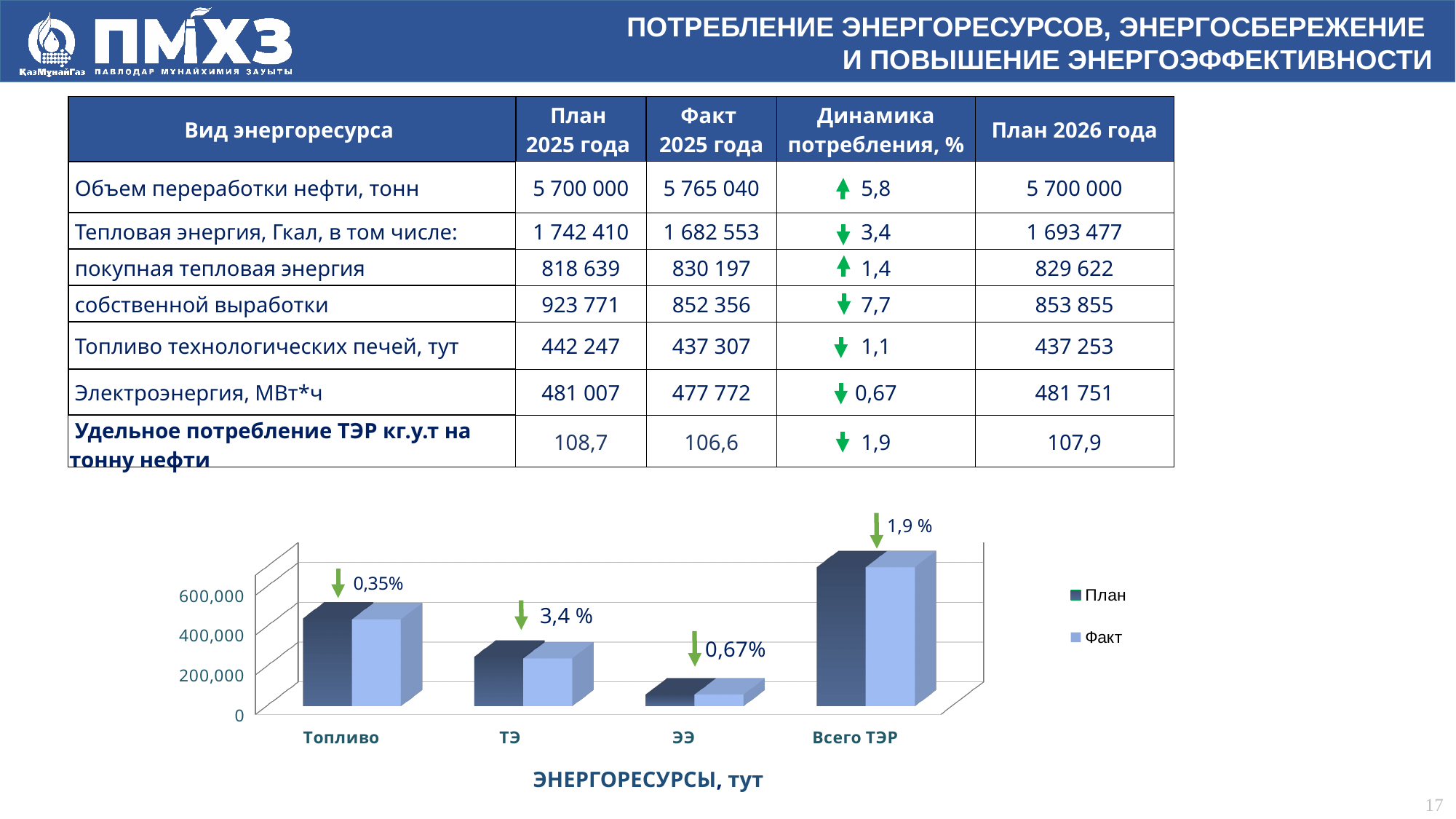
Which category has the highest bars in the chart? Всего ТЭР Is the План value for ТЭ greater or less than 400,000? less How many categories are shown on the x axis of the chart? 4 Is the Факт value for ЭЭ greater or less than 200,000? less Which category has the lowest bars in the chart? ЭЭ How many series does the chart legend list? 2 What is the title of the chart? ЭНЕРГОРЕСУРСЫ, тут What percentage change is labelled above the Топливо bars in the chart? 0,35% What kind of chart is shown at the bottom of the slide? bar chart Is the План value for Всего ТЭР greater or less than 600,000? greater What percentage change is labelled above the Всего ТЭР bars in the chart? 1,9 % Which is larger in the chart, the План value for Топливо or the План value for ТЭ? Топливо